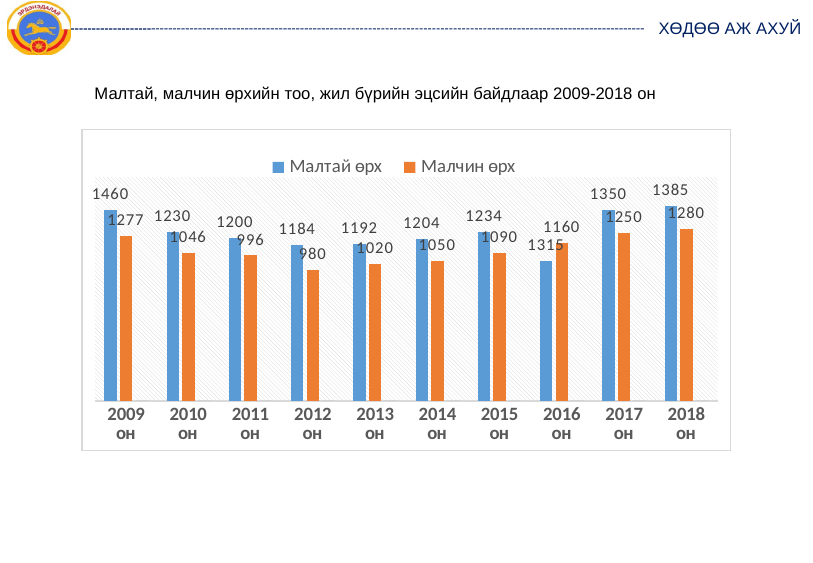
What kind of chart is shown on the slide? Bar chart What is the difference between Малтай өрх and Малчин өрх in 2018 он? 105 In which year is the value for Малтай өрх highest? 2009 он How many series does the legend list? 2 What is the value for Малтай өрх in 2014 он? 1204 What is the value for Малтай өрх in 2009 он? 1460 What is the value for Малчин өрх in 2017 он? 1250 What is the difference between Малтай өрх and Малчин өрх in 2009 он? 183 In which year is the value for Малчин өрх lowest? 2012 он Which is larger, the value for Малтай өрх in 2009 он or in 2018 он? 2009 он What is the value for Малчин өрх in 2011 он? 996 How many years are shown on the x axis? 10